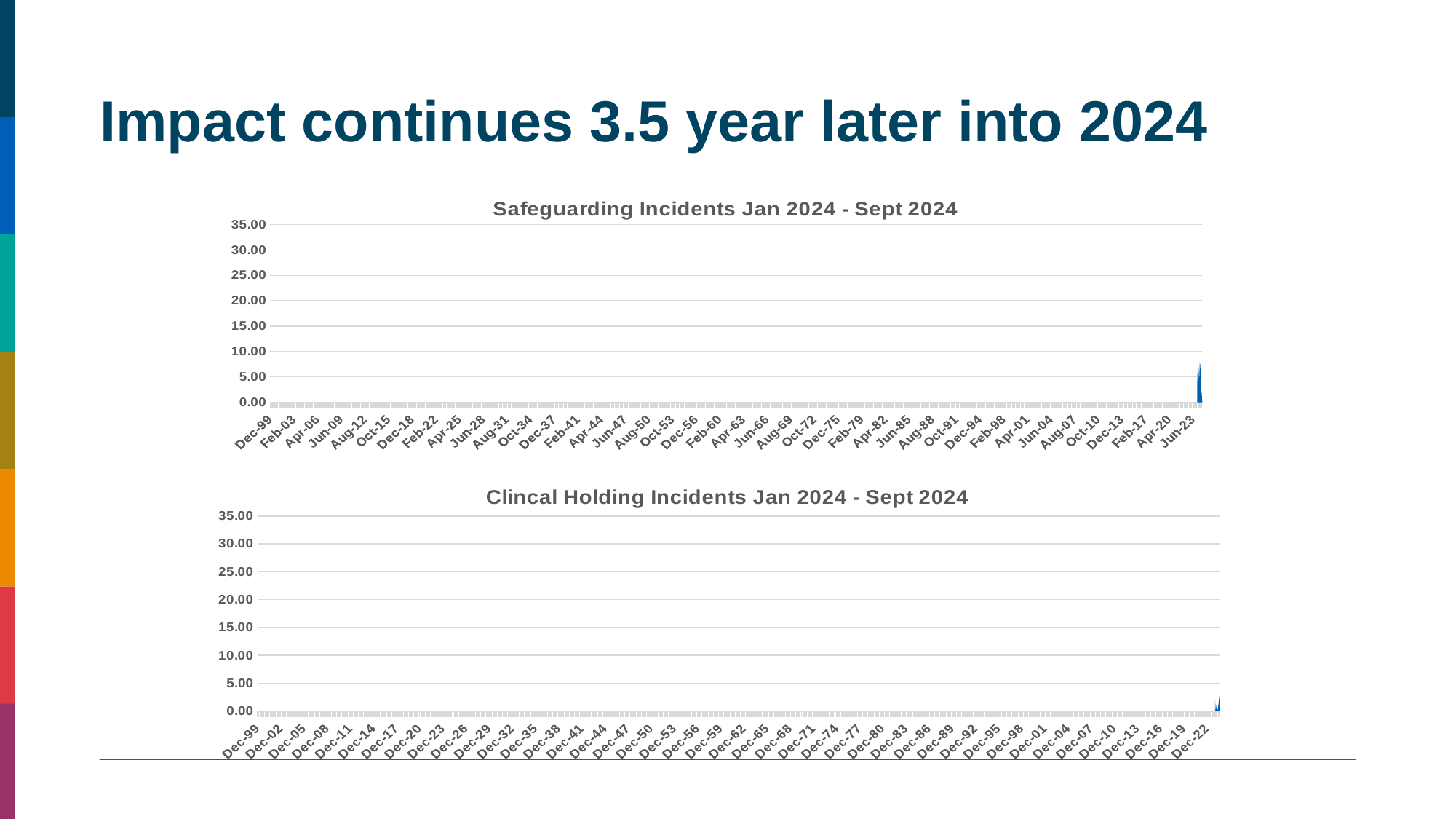
In the 'Safeguarding Incidents Jan 2024 - Sept 2024' chart, is the highest bar value greater or less than 5.00? greater In the 'Clincal Holding Incidents Jan 2024 - Sept 2024' chart, is the highest bar value greater or less than 10.00? less In the 'Safeguarding Incidents Jan 2024 - Sept 2024' chart, is the highest bar value greater or less than 10.00? less Which chart has the higher peak bar value, 'Safeguarding Incidents Jan 2024 - Sept 2024' or 'Clincal Holding Incidents Jan 2024 - Sept 2024'? Safeguarding Incidents Jan 2024 - Sept 2024 What kind of chart is the 'Safeguarding Incidents Jan 2024 - Sept 2024' chart? area chart What is the title of the bottom chart on the slide? Clincal Holding Incidents Jan 2024 - Sept 2024 In the 'Safeguarding Incidents Jan 2024 - Sept 2024' chart, do the non-zero bars appear at the start or at the end of the x axis? at the end In the 'Clincal Holding Incidents Jan 2024 - Sept 2024' chart, do the non-zero bars appear at the start or at the end of the x axis? at the end What kind of chart is the 'Clincal Holding Incidents Jan 2024 - Sept 2024' chart? area chart What is the title of the top chart on the slide? Safeguarding Incidents Jan 2024 - Sept 2024